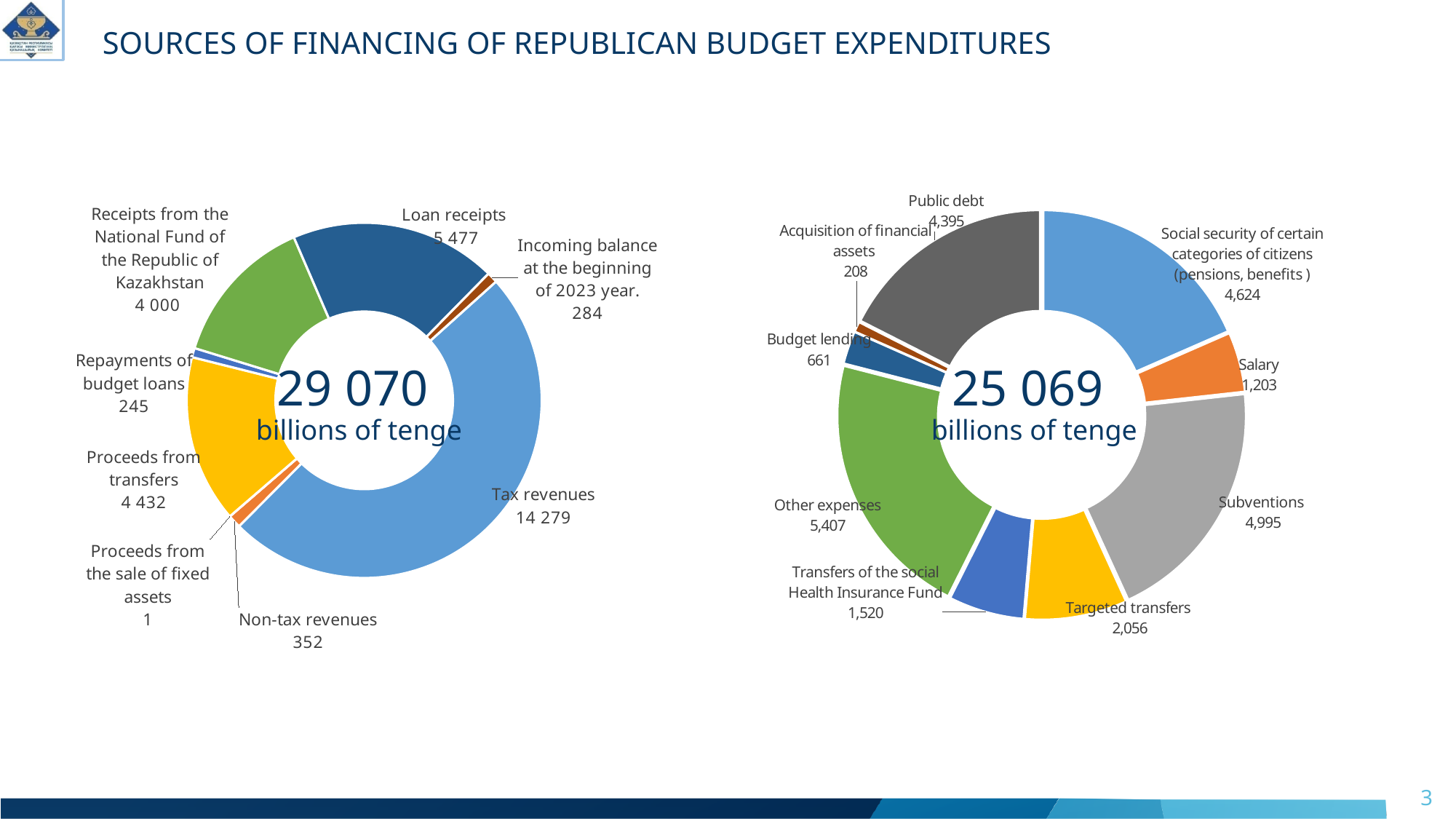
On the left chart (29 070 billions of tenge), what is the difference between Proceeds from transfers and Receipts from the National Fund of the Republic of Kazakhstan? 432 On the left chart (29 070 billions of tenge), what is the value for Loan receipts? 5 477 On the right chart (25 069 billions of tenge), which is larger: Public debt or Social security of certain categories of citizens (pensions, benefits)? Social security of certain categories of citizens (pensions, benefits) On the left chart (29 070 billions of tenge), which category has the largest value? Tax revenues On the left chart (29 070 billions of tenge), what is the value for Tax revenues? 14 279 On the right chart (25 069 billions of tenge), what is the value for Subventions? 4,995 On the right chart (25 069 billions of tenge), what is the value for Budget lending? 661 What type of chart is used on the left side of the slide? Doughnut chart On the left chart (29 070 billions of tenge), which category has the smallest value? Proceeds from the sale of fixed assets On the left chart (29 070 billions of tenge), how many categories are shown? 8 On the right chart (25 069 billions of tenge), how many categories are shown? 9 On the right chart (25 069 billions of tenge), which category has the largest value? Other expenses